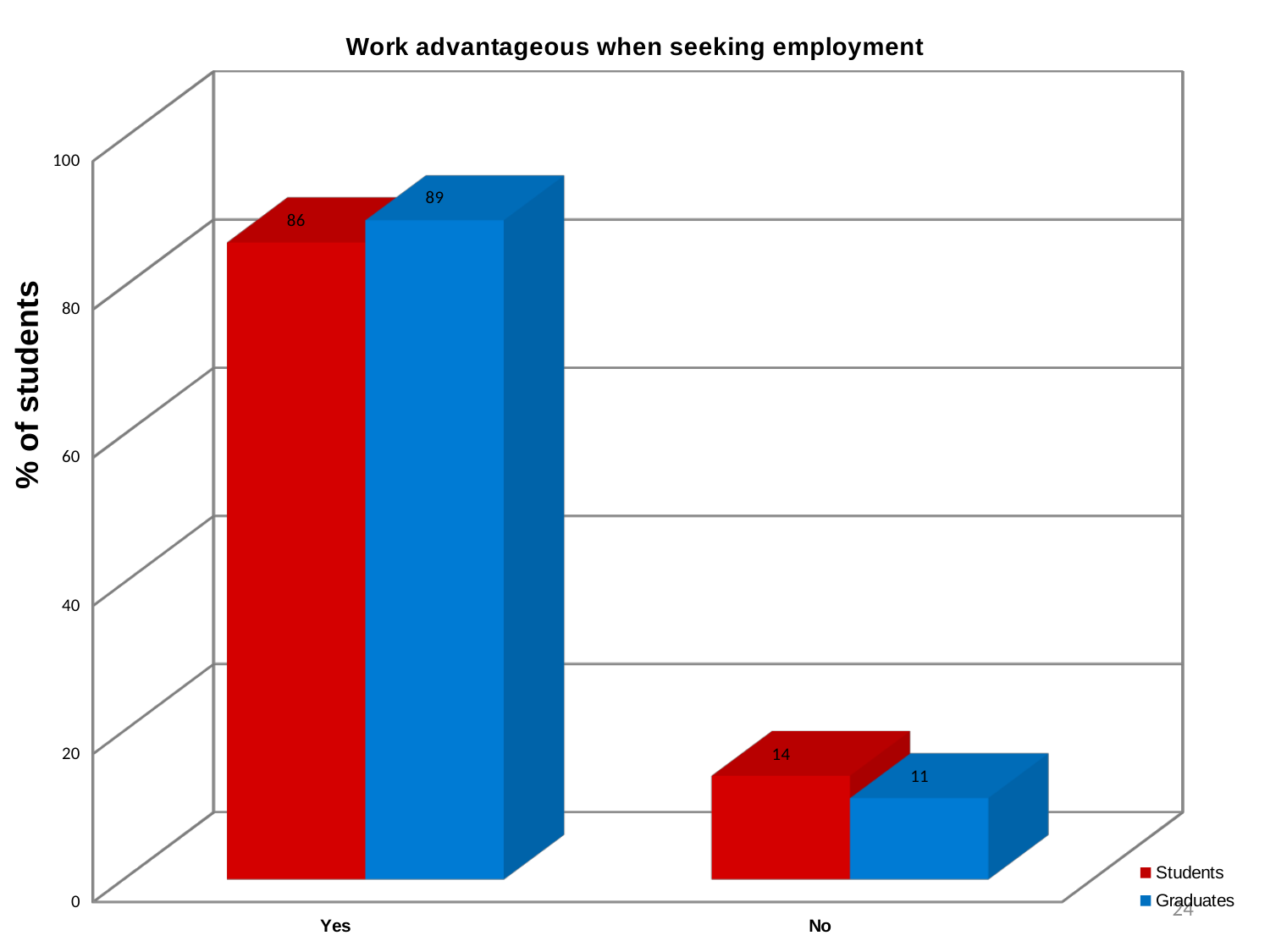
What is the title of the chart? Work advantageous when seeking employment What is the value for Students in the No category? 14 Which series has the higher value in the No category? Students How many series does the legend list? 2 What is the value for Graduates in the No category? 11 What kind of chart is shown? Bar chart What is the value for Graduates in the Yes category? 89 What is the difference between the Graduates and Students values in the Yes category? 3 What is the difference between the Students and Graduates values in the No category? 3 What is the value for Students in the Yes category? 86 Which series has the higher value in the Yes category? Graduates How many categories are shown on the x axis? 2